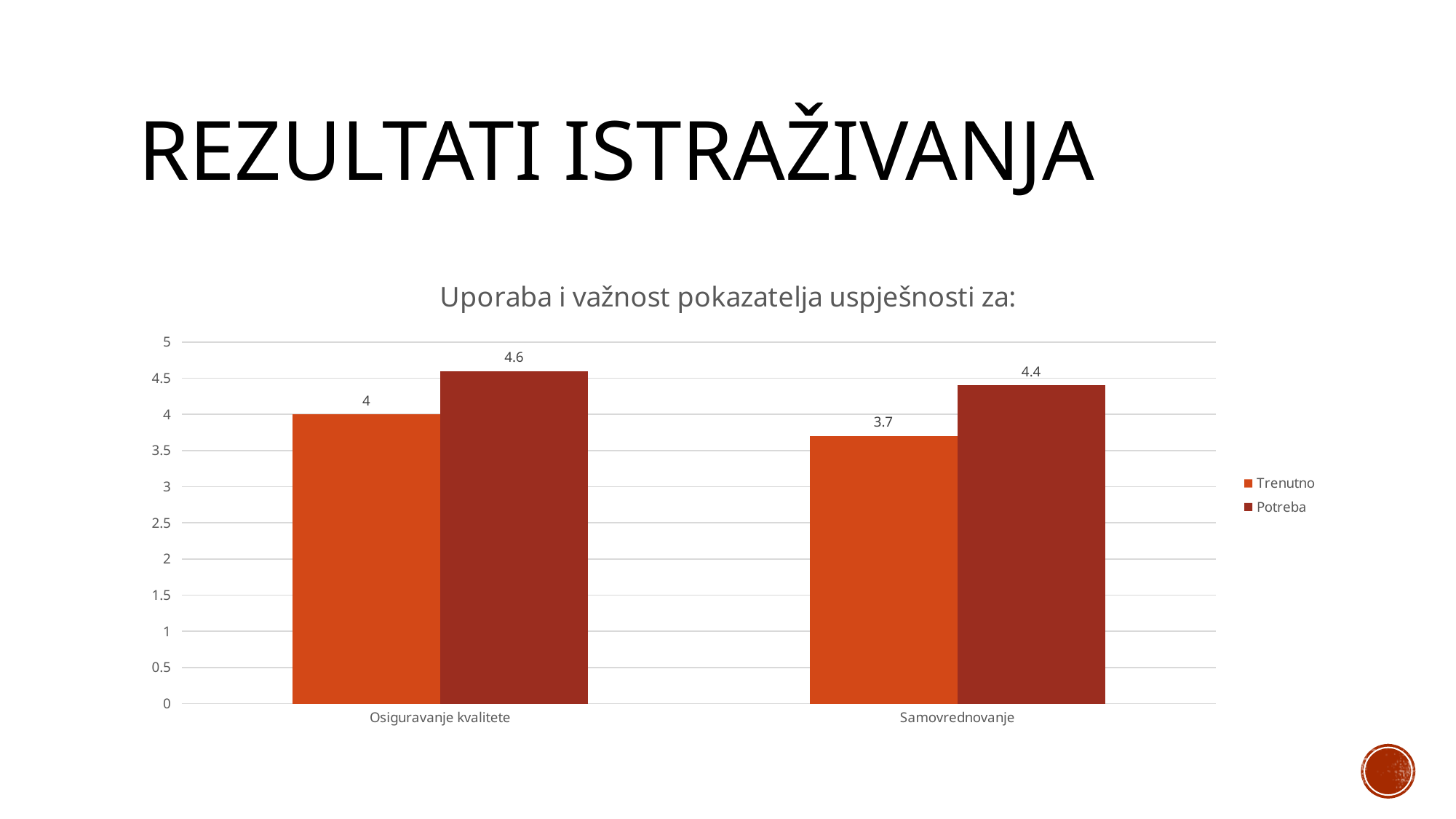
How many series does the legend list? 2 What is the Potreba value for Samovrednovanje? 4.4 Which category has the lowest Trenutno value? Samovrednovanje What is the difference between the Potreba and Trenutno values for Samovrednovanje? 0.7 Which category has the highest Potreba value? Osiguravanje kvalitete What is the difference between the Potreba and Trenutno values for Osiguravanje kvalitete? 0.6 What is the Potreba value for Osiguravanje kvalitete? 4.6 What kind of chart is shown on the slide? Bar chart Which is larger for Samovrednovanje, Trenutno or Potreba? Potreba How many categories are shown on the x axis? 2 What is the Trenutno value for Samovrednovanje? 3.7 What is the Trenutno value for Osiguravanje kvalitete? 4